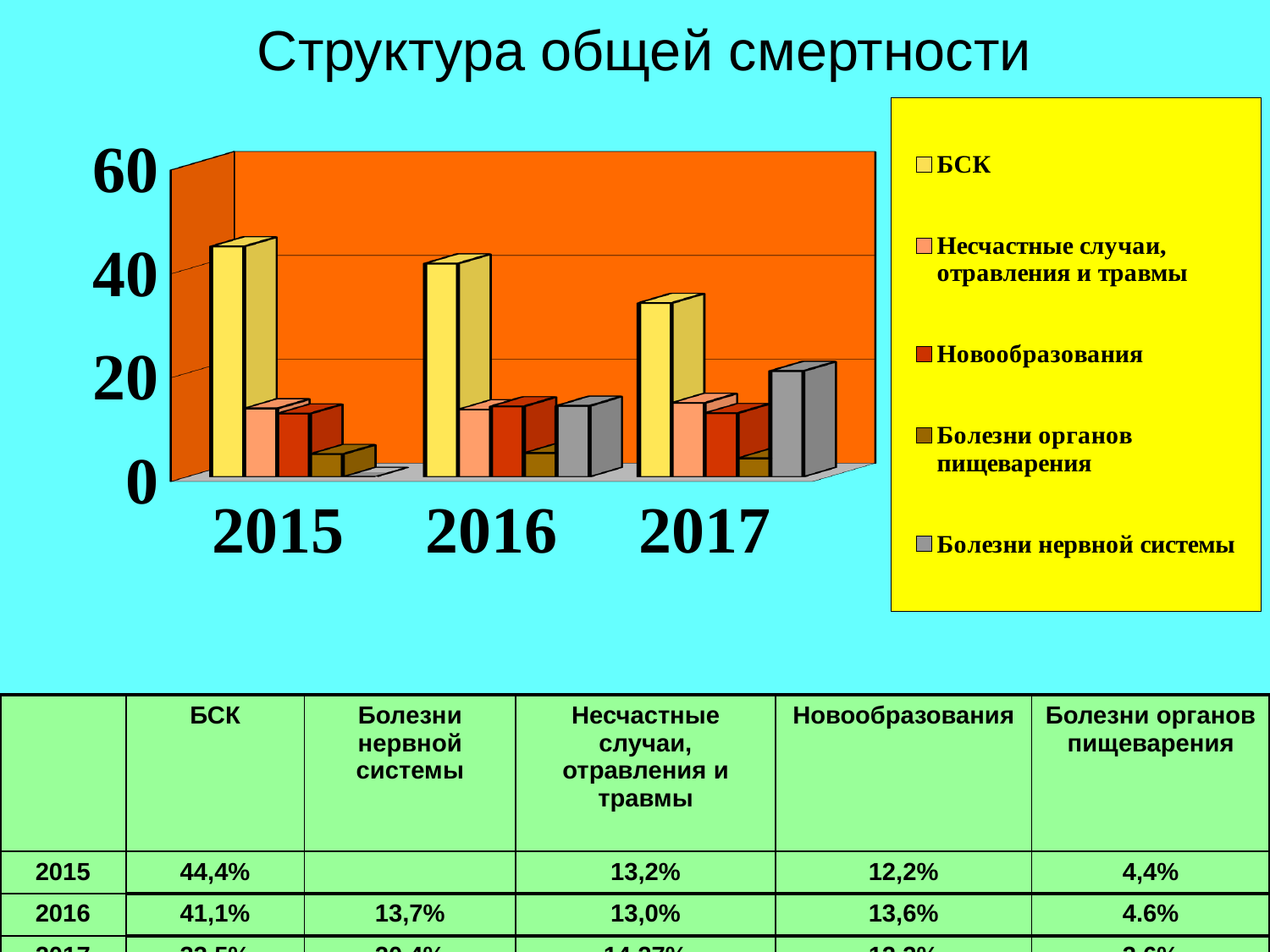
How many years are shown along the x axis of the chart? 3 What is the title of the chart? Структура общей смертности What is the value for Новообразования in 2016? 13,6% How many series does the chart legend list? 5 What is the difference between the БСК values for 2015 and 2016? 3,3% What is the value for БСК in 2015? 44,4% Is the value for БСК in 2017 greater or less than 40? less Which is larger in 2016: Несчастные случаи, отравления и травмы or Болезни органов пищеварения? Несчастные случаи, отравления и травмы Which series has the highest value in every year shown? БСК What kind of chart is shown on the slide? bar chart What is the value for Болезни органов пищеварения in 2015? 4,4% Does the value for БСК rise or fall from 2015 to 2017? fall